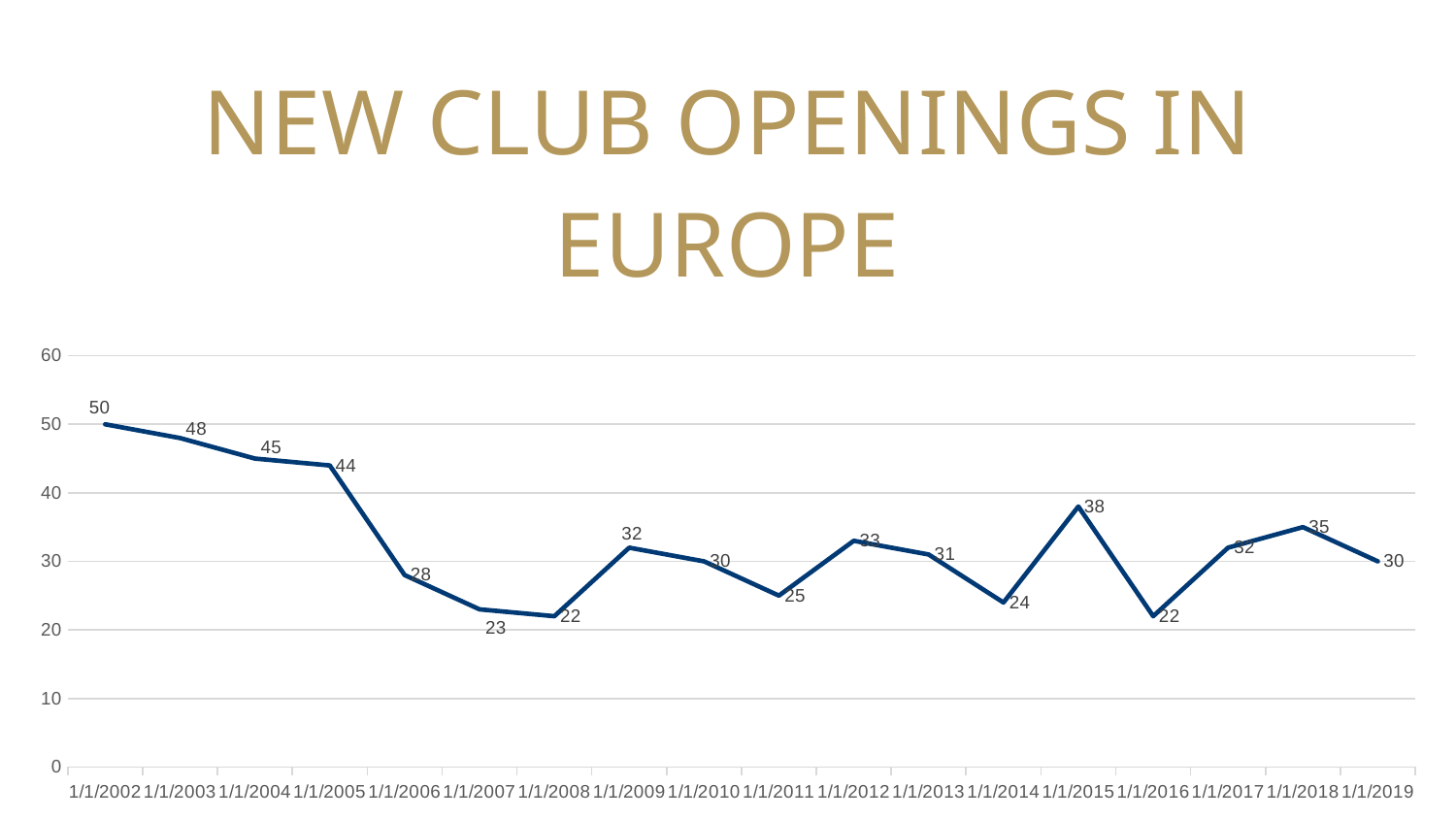
Do the values rise or fall from 1/1/2002 to 1/1/2005? fall Which is larger, the value for 1/1/2018 or the value for 1/1/2019? 1/1/2018 What is the title of the chart? NEW CLUB OPENINGS IN EUROPE How many data points are plotted on the chart? 18 Which date has the highest value? 1/1/2002 What is the difference between the values for 1/1/2005 and 1/1/2006? 16 What is the value for 1/1/2002? 50 What is the value for 1/1/2011? 25 What is the value for 1/1/2015? 38 What type of chart is shown on the slide? line chart Is the value for 1/1/2014 greater or less than 30? less What is the lowest value plotted on the chart? 22